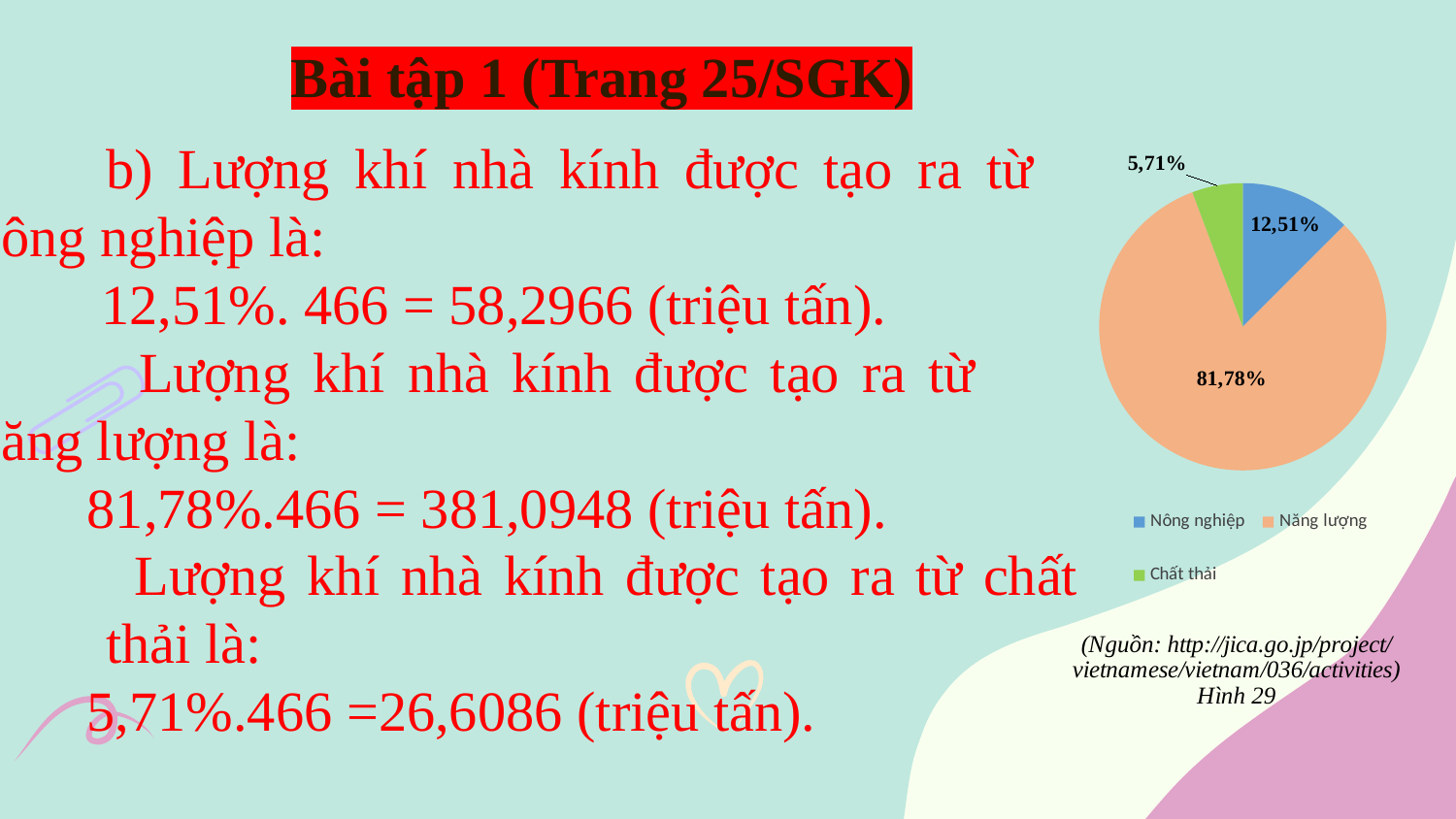
How many slices does the pie chart have? 3 What is the difference between the Năng lượng share and the Nông nghiệp share? 69,27% What kind of chart is shown on the slide? Pie chart What share of the pie does Nông nghiệp have? 12,51% Which category has the largest slice of the pie? Năng lượng What share of the pie does Chất thải have? 5,71% What colour is the Chất thải slice in the pie chart? Green Which is larger, the slice for Nông nghiệp or the slice for Chất thải? Nông nghiệp How many entries does the legend list? 3 Which category has the smallest slice of the pie? Chất thải What colour is the Năng lượng slice in the pie chart? Orange What share of the pie does Năng lượng have? 81,78%